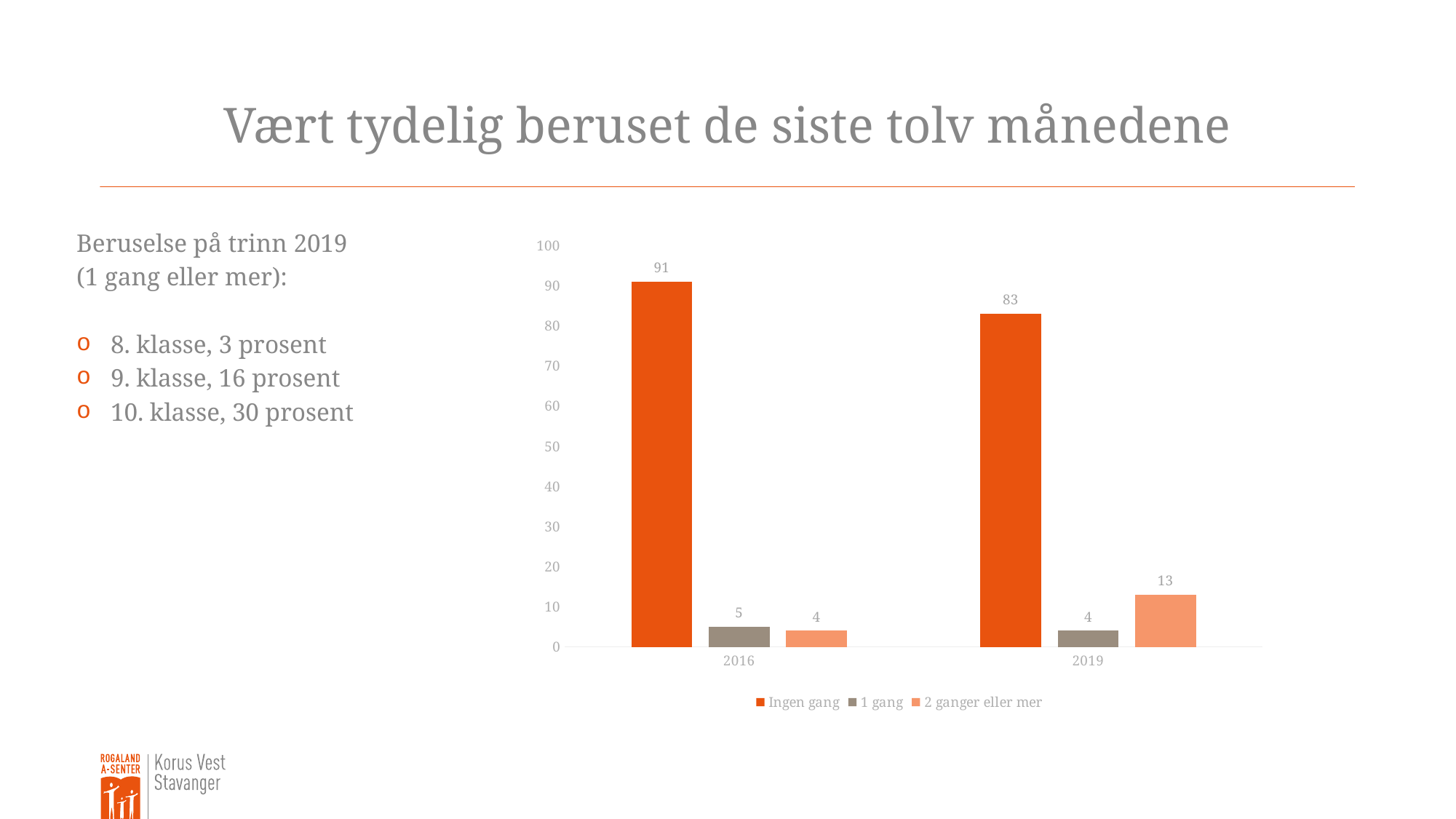
What is the difference between the "Ingen gang" values for 2016 and 2019? 8 How many series does the legend list? 3 What is the value for "Ingen gang" in 2016? 91 What kind of chart is shown on the slide? Bar chart Which is larger: "2 ganger eller mer" in 2016 or in 2019? 2019 What is the value for "Ingen gang" in 2019? 83 What is the value for "1 gang" in 2016? 5 What is the value for "2 ganger eller mer" in 2016? 4 What is the value for "2 ganger eller mer" in 2019? 13 Which series has the highest value in 2019? Ingen gang Which series has the lowest value in 2016? 2 ganger eller mer Does the "Ingen gang" value rise or fall from 2016 to 2019? Fall